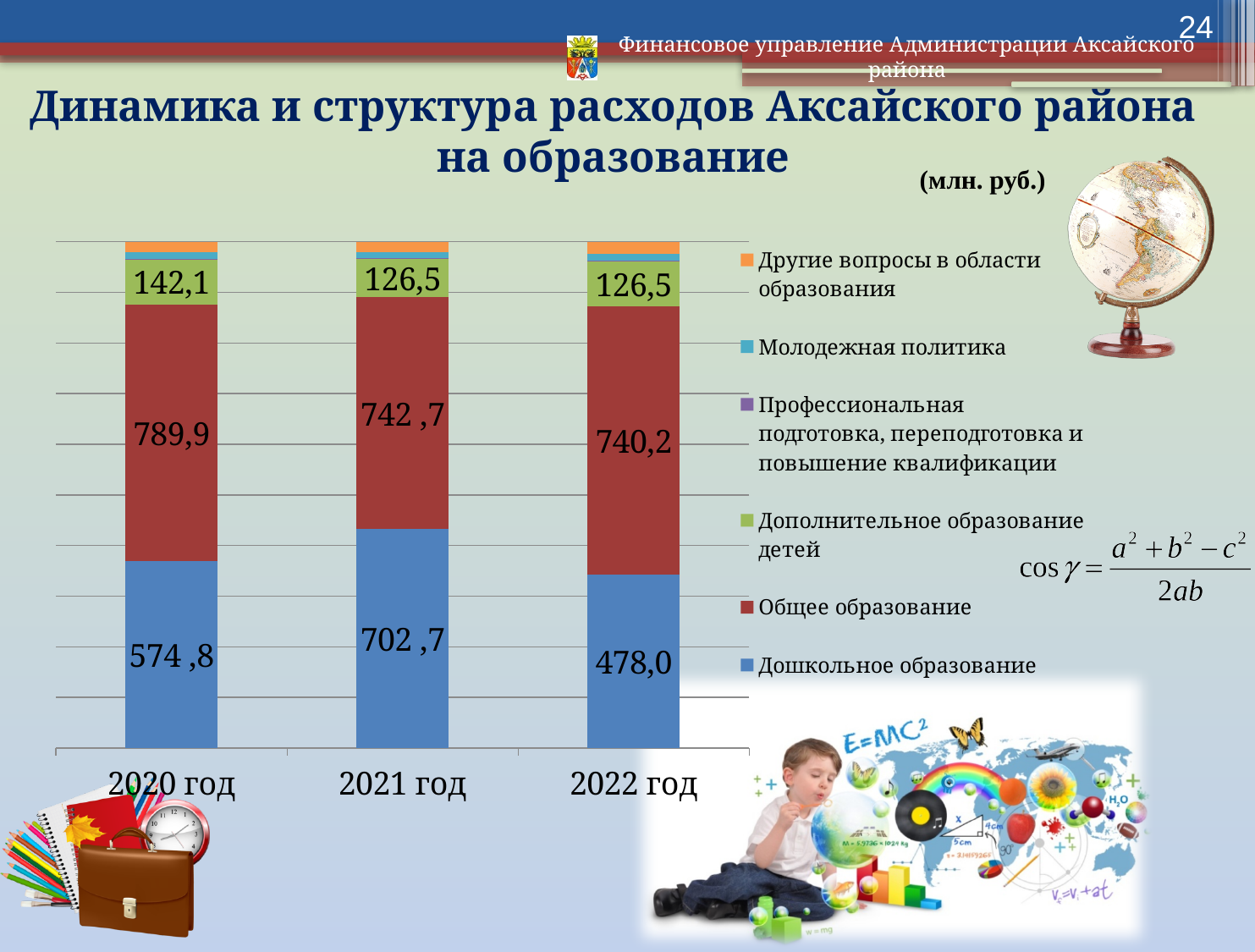
What is the difference between the Дошкольное образование values for 2021 год and 2022 год? 224,7 What is the value for Дошкольное образование in 2022 год? 478,0 Which is larger: Общее образование in 2020 год or Общее образование in 2022 год? 2020 год In which year is the value for Дошкольное образование the highest? 2021 год In which year is the value for Общее образование the lowest? 2022 год How many years are shown on the x axis? 3 What is the value for Дополнительное образование детей in 2021 год? 126,5 What kind of chart is shown on the slide? Stacked bar chart What is the difference between the Дополнительное образование детей values for 2020 год and 2021 год? 15,6 What is the value for Общее образование in 2020 год? 789,9 Does the value for Общее образование rise or fall from 2020 год to 2022 год? Fall How many series does the legend list? 6